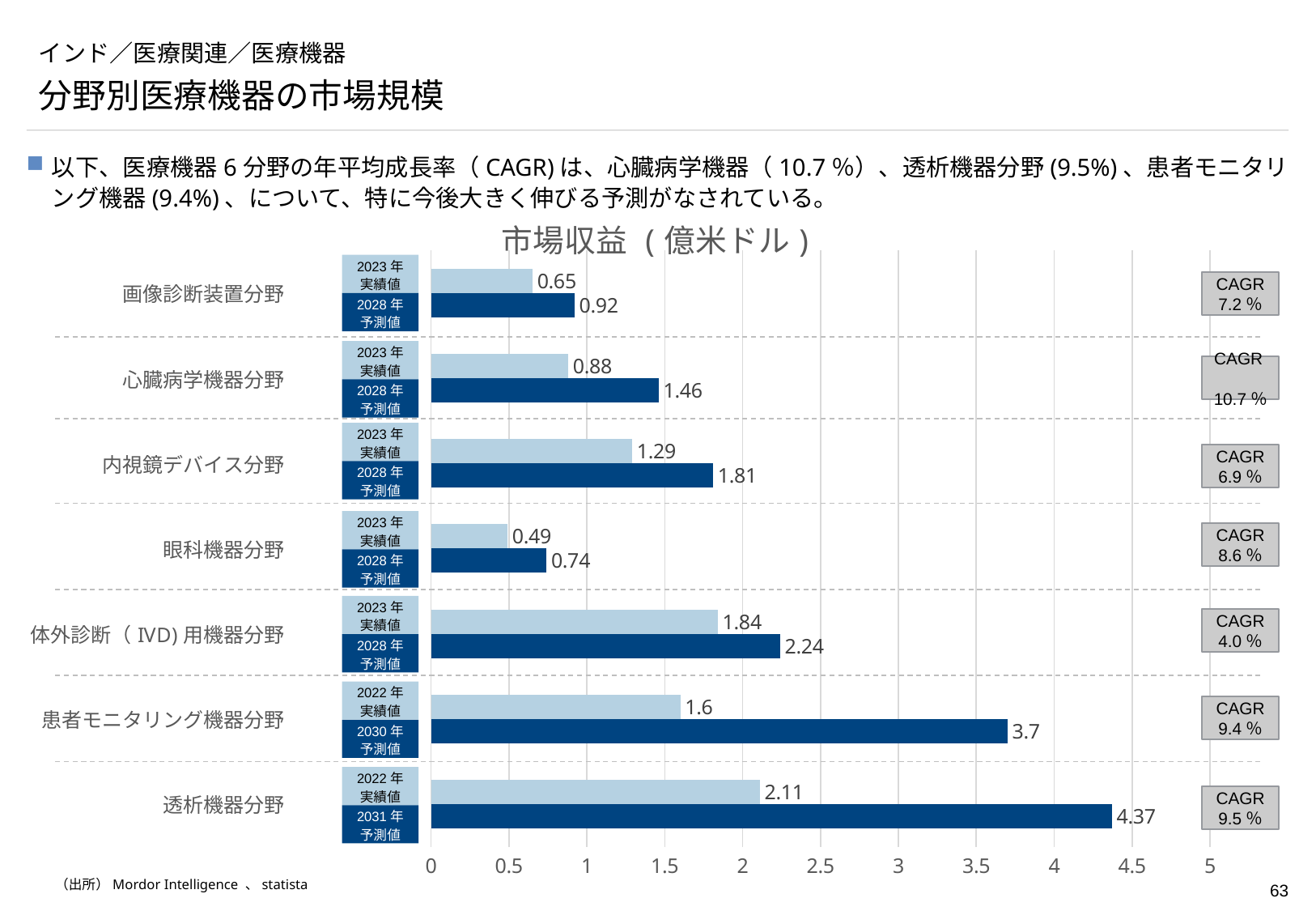
予測値が最も大きい分野はどれですか？ 透析機器分野 これはどの種類のグラフですか？ 棒グラフ 内視鏡デバイス分野の2028年予測値と体外診断（IVD）用機器分野の2023年実績値では、どちらが大きいですか？ 体外診断（IVD）用機器分野の2023年実績値 このグラフのタイトルは何ですか？ 市場収益（億米ドル） 患者モニタリング機器分野のCAGRはいくらですか？ 9.4 % 実績値が最も小さい分野はどれですか？ 眼科機器分野 眼科機器分野の2028年予測値は1より大きいですか、小さいですか？ 小さい 心臓病学機器分野の2023年実績値はいくらですか？ 0.88 透析機器分野の2031年予測値はいくらですか？ 4.37 このグラフにはいくつの分野が示されていますか？ 7 患者モニタリング機器分野の2030年予測値と2022年実績値の差はいくらですか？ 2.1 画像診断装置分野の2028年予測値はいくらですか？ 0.92